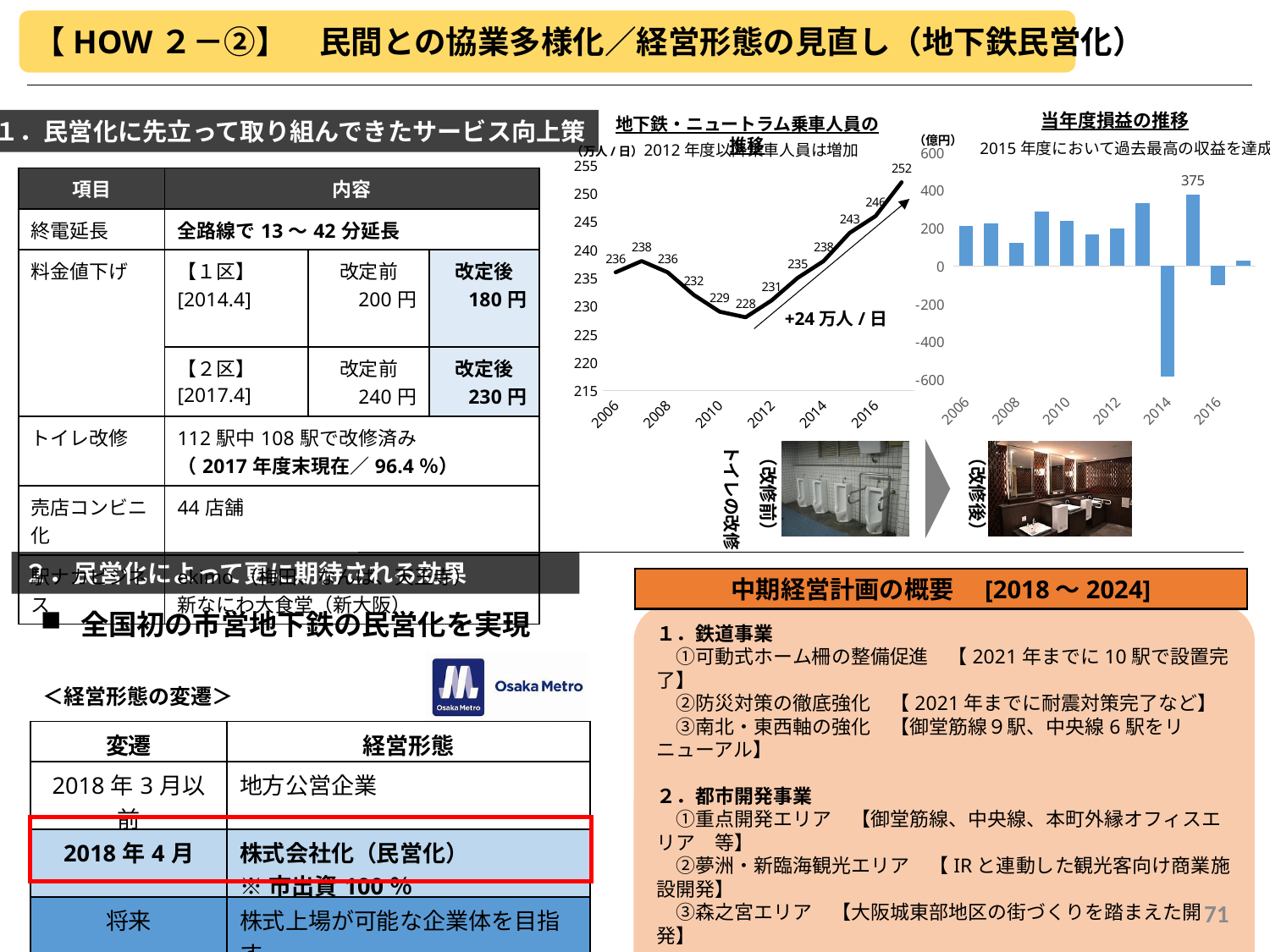
In the 地下鉄・ニュートラム乗車人員の推移 chart, how many data points are plotted? 12 In the 地下鉄・ニュートラム乗車人員の推移 chart, what is the highest value shown? 252 In the 地下鉄・ニュートラム乗車人員の推移 chart, what is the difference between the highest value (252) and the lowest value (228)? 24 In the 地下鉄・ニュートラム乗車人員の推移 chart, what is the value for 2010? 229 In the 当年度損益の推移 chart, which year has the lowest value? 2014 What kind of chart is the 当年度損益の推移 chart? bar chart In the 当年度損益の推移 chart, which year has the highest value? 2015 In the 地下鉄・ニュートラム乗車人員の推移 chart, do the values rise or fall from 2011 to 2017? rise In the 地下鉄・ニュートラム乗車人員の推移 chart, what is the lowest value shown? 228 What kind of chart is the 地下鉄・ニュートラム乗車人員の推移 chart? line chart In the 当年度損益の推移 chart, is the value for 2014 greater or less than -400? less In the 地下鉄・ニュートラム乗車人員の推移 chart, what is the value for 2006? 236